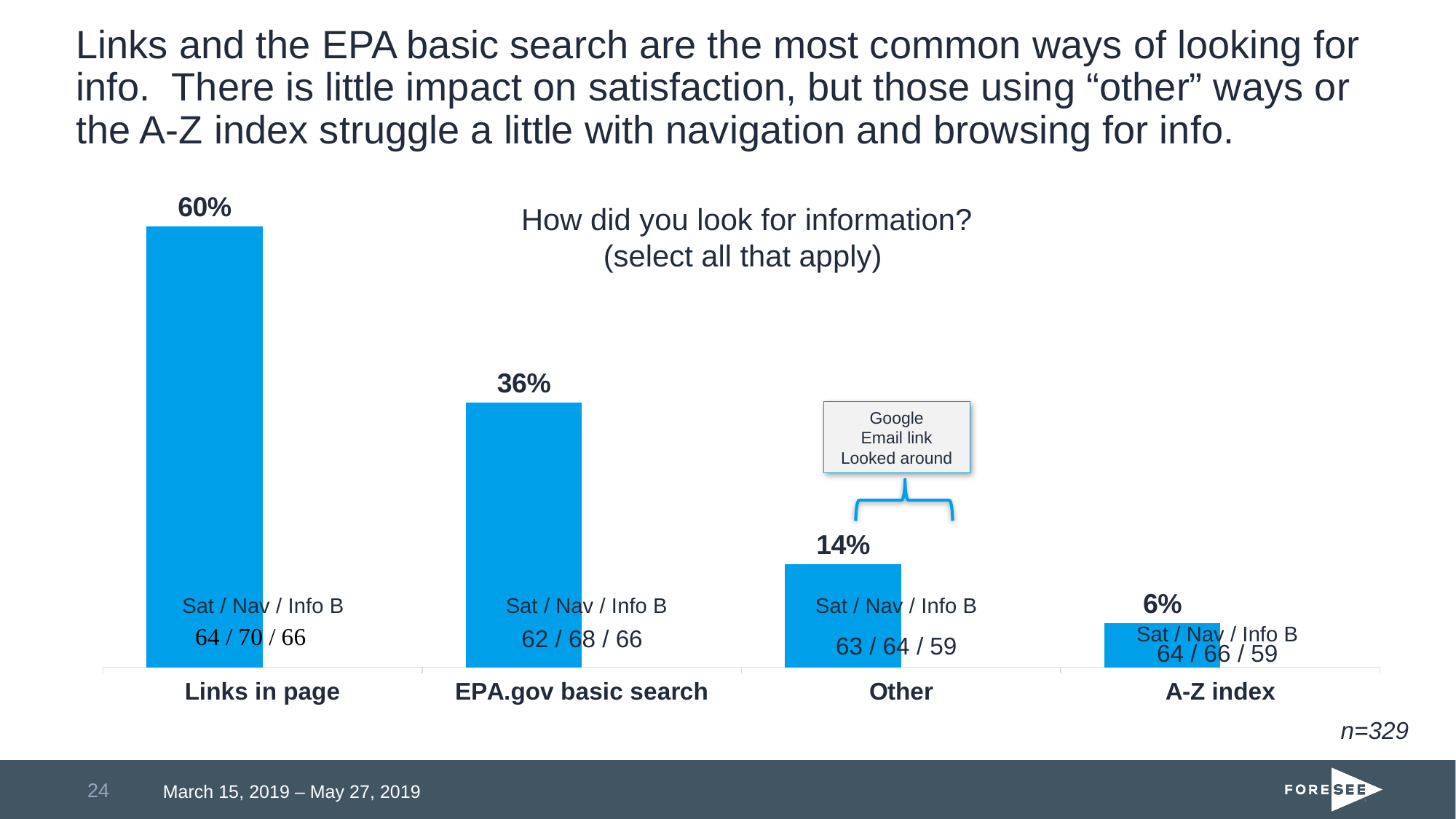
What is the difference in percentage points between Other and A-Z index? 8 What kind of chart is shown on the slide? Bar chart What percentage of respondents used the EPA.gov basic search to look for information? 36% Do the percentages rise or fall moving from left to right across the categories? Fall Which is larger, the percentage for EPA.gov basic search or for Other? EPA.gov basic search What is the difference in percentage points between Links in page and EPA.gov basic search? 24 What percentage of respondents used the A-Z index? 6% Which way of looking for information has the highest percentage? Links in page Which way of looking for information has the lowest percentage? A-Z index How many ways of looking for information are shown on the chart? 4 What is the title of the chart? How did you look for information? (select all that apply) What percentage of respondents looked for information using links in page? 60%